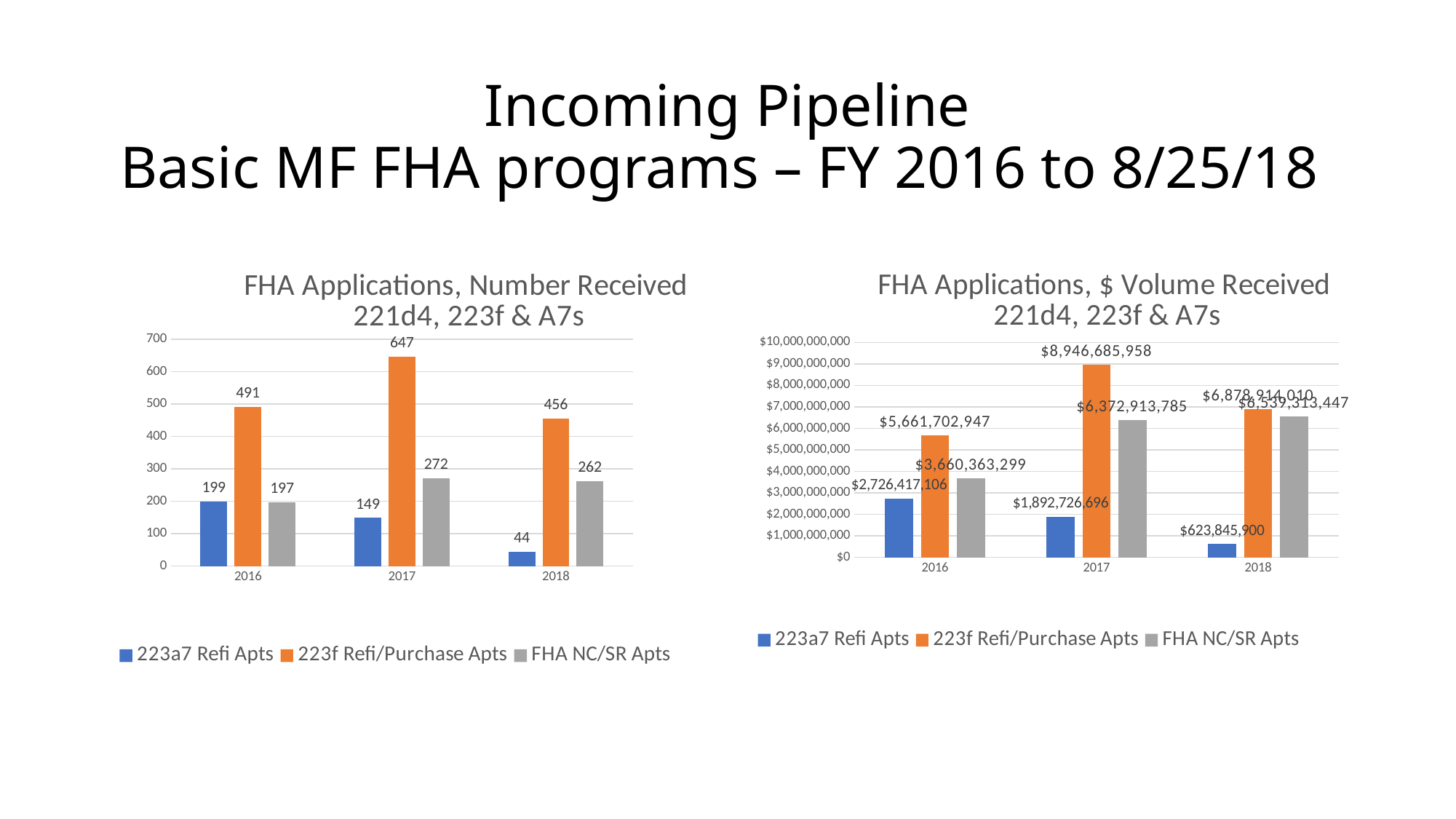
In the 'FHA Applications, $ Volume Received' chart, which series has the lowest value in 2018? 223a7 Refi Apts In the 'FHA Applications, Number Received' chart, which year has the highest value for 223f Refi/Purchase Apts? 2017 In the 'FHA Applications, Number Received' chart, what is the value for 223f Refi/Purchase Apts in 2017? 647 In the 'FHA Applications, $ Volume Received' chart, what is the value for 223f Refi/Purchase Apts in 2017? $8,946,685,958 In the 'FHA Applications, Number Received' chart, do the values for 223a7 Refi Apts rise or fall from 2016 to 2018? fall What kind of chart is the 'FHA Applications, $ Volume Received' chart? bar chart In the 'FHA Applications, $ Volume Received' chart, is the value for FHA NC/SR Apts in 2017 greater or less than $6,000,000,000? greater In the 'FHA Applications, $ Volume Received' chart, how many series does the legend list? 3 In the 'FHA Applications, Number Received' chart, what is the difference between FHA NC/SR Apts in 2017 and in 2018? 10 In the 'FHA Applications, $ Volume Received' chart, what is the value for 223a7 Refi Apts in 2016? $2,726,417,106 In the 'FHA Applications, Number Received' chart, what is the value for 223a7 Refi Apts in 2018? 44 In the 'FHA Applications, Number Received' chart, how many years are shown on the x axis? 3